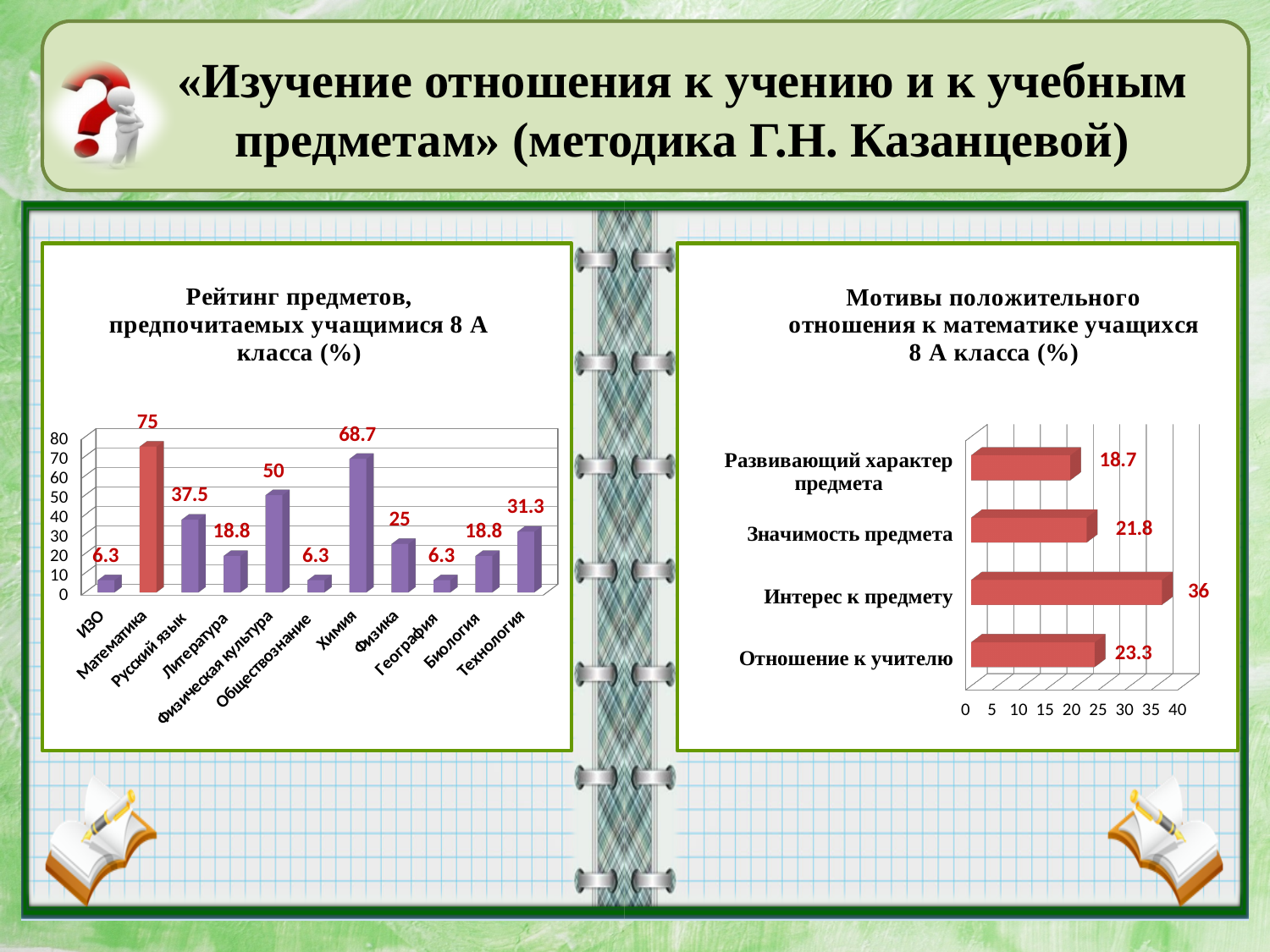
In the left chart (Рейтинг предметов), what is the value for Химия? 68.7 In the right chart (Мотивы положительного отношения к математике), what is the value for Интерес к предмету? 36 In the left chart (Рейтинг предметов, предпочитаемых учащимися 8 А класса), what is the value for Математика? 75 In the left chart (Рейтинг предметов), what is the difference between the values for Математика and Химия? 6.3 In the left chart (Рейтинг предметов), how many subjects are shown on the x axis? 11 In the right chart (Мотивы положительного отношения к математике), which motive has the lowest value? Развивающий характер предмета In the right chart (Мотивы положительного отношения к математике), how many categories are shown? 4 In the left chart (Рейтинг предметов), which subject has the highest value? Математика What type of chart is the right chart (Мотивы положительного отношения к математике)? Bar chart In the left chart (Рейтинг предметов), which is larger, the value for Русский язык or the value for Технология? Русский язык In the right chart (Мотивы положительного отношения к математике), what is the difference between the values for Интерес к предмету and Отношение к учителю? 12.7 In the left chart (Рейтинг предметов), what is the value for Физическая культура? 50